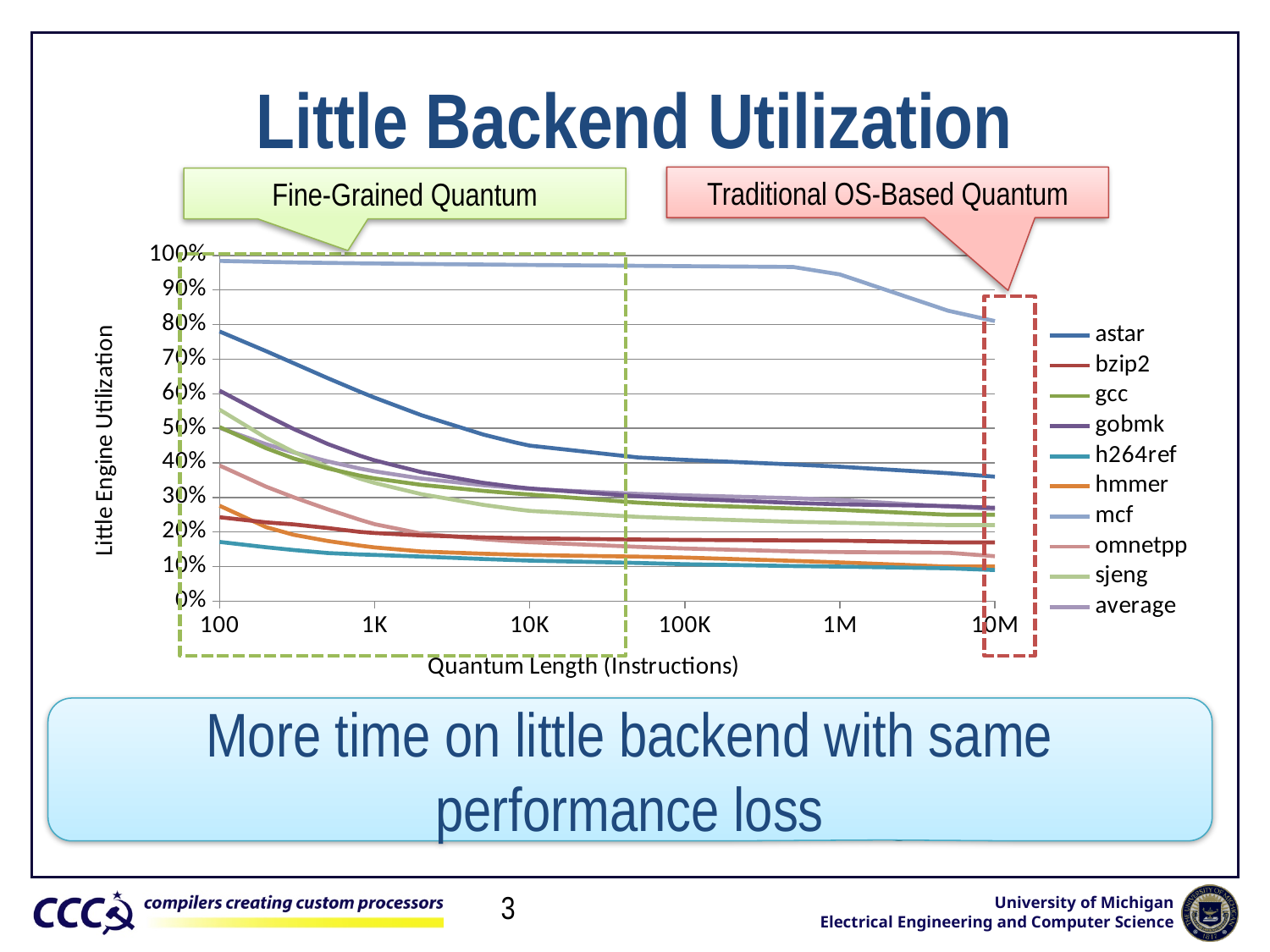
Is the value for mcf at a quantum length of 10M greater or less than 90%? less Does the utilization for astar rise or fall as quantum length increases? fall Is the value for mcf at a quantum length of 100 greater or less than 90%? greater How many quantum length values are labelled on the x axis? 6 At a quantum length of 100, which has the higher utilization, astar or gobmk? astar What kind of chart is shown on the slide? line chart How many series does the legend list? 10 Which series has the lowest Little Engine Utilization at a quantum length of 100? h264ref What is the title of the x axis? Quantum Length (Instructions) Is the value for astar at a quantum length of 100 greater or less than 70%? greater Which series has the highest Little Engine Utilization at a quantum length of 100? mcf